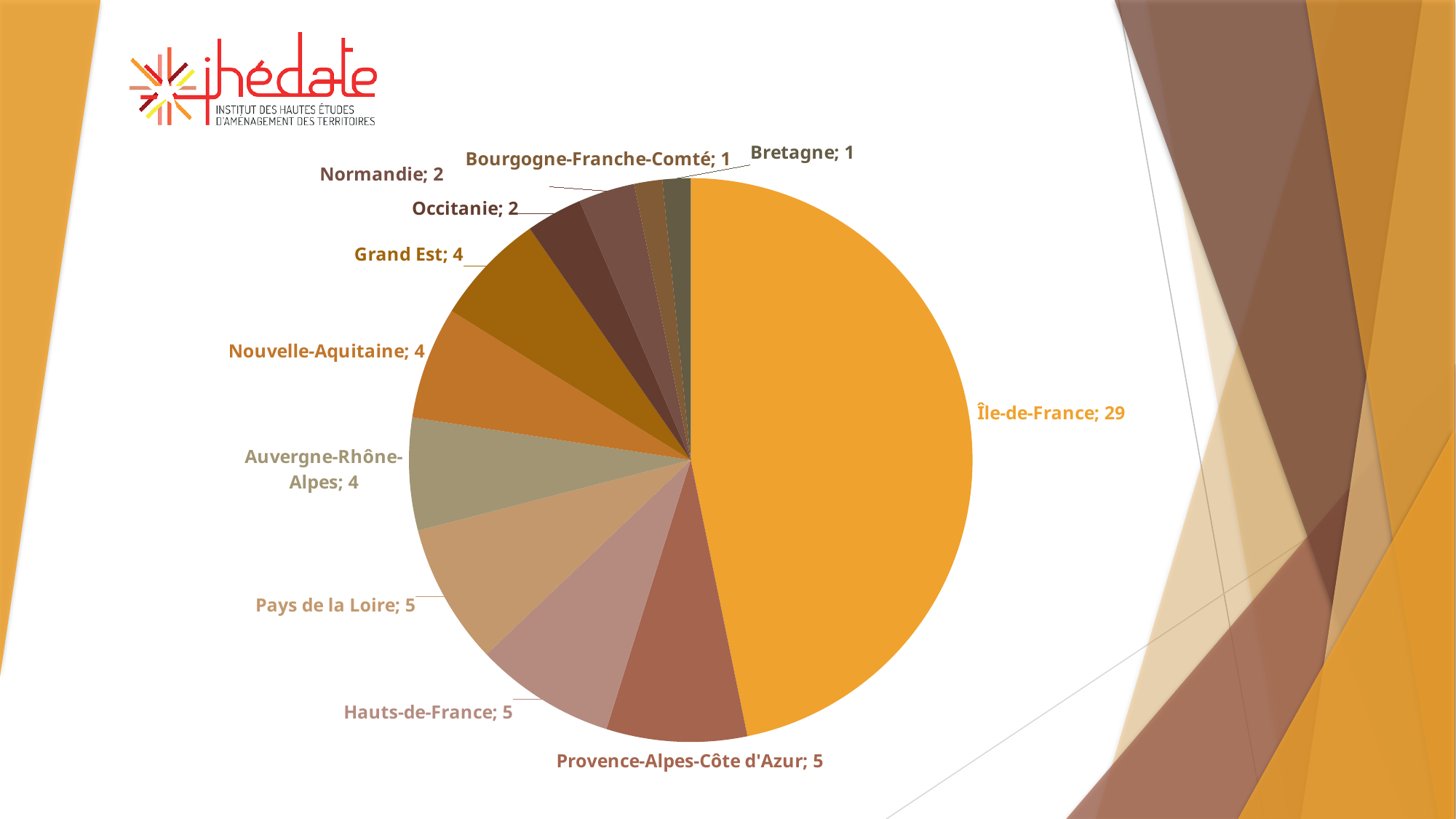
How many regions (slices) are shown in the pie chart? 11 Which two regions each have a value of 1? Bourgogne-Franche-Comté and Bretagne What kind of chart is shown on the slide? pie chart Which is larger, the value for Nouvelle-Aquitaine or the value for Occitanie? Nouvelle-Aquitaine What is the difference between the values for Hauts-de-France and Normandie? 3 What is the value for Bretagne? 1 What is the total of all the slice values in the pie chart? 62 What is the value for Pays de la Loire? 5 What is the difference between the values for Île-de-France and Provence-Alpes-Côte d'Azur? 24 Which region has the largest slice of the pie? Île-de-France What is the value for Grand Est? 4 What is the value for Île-de-France? 29